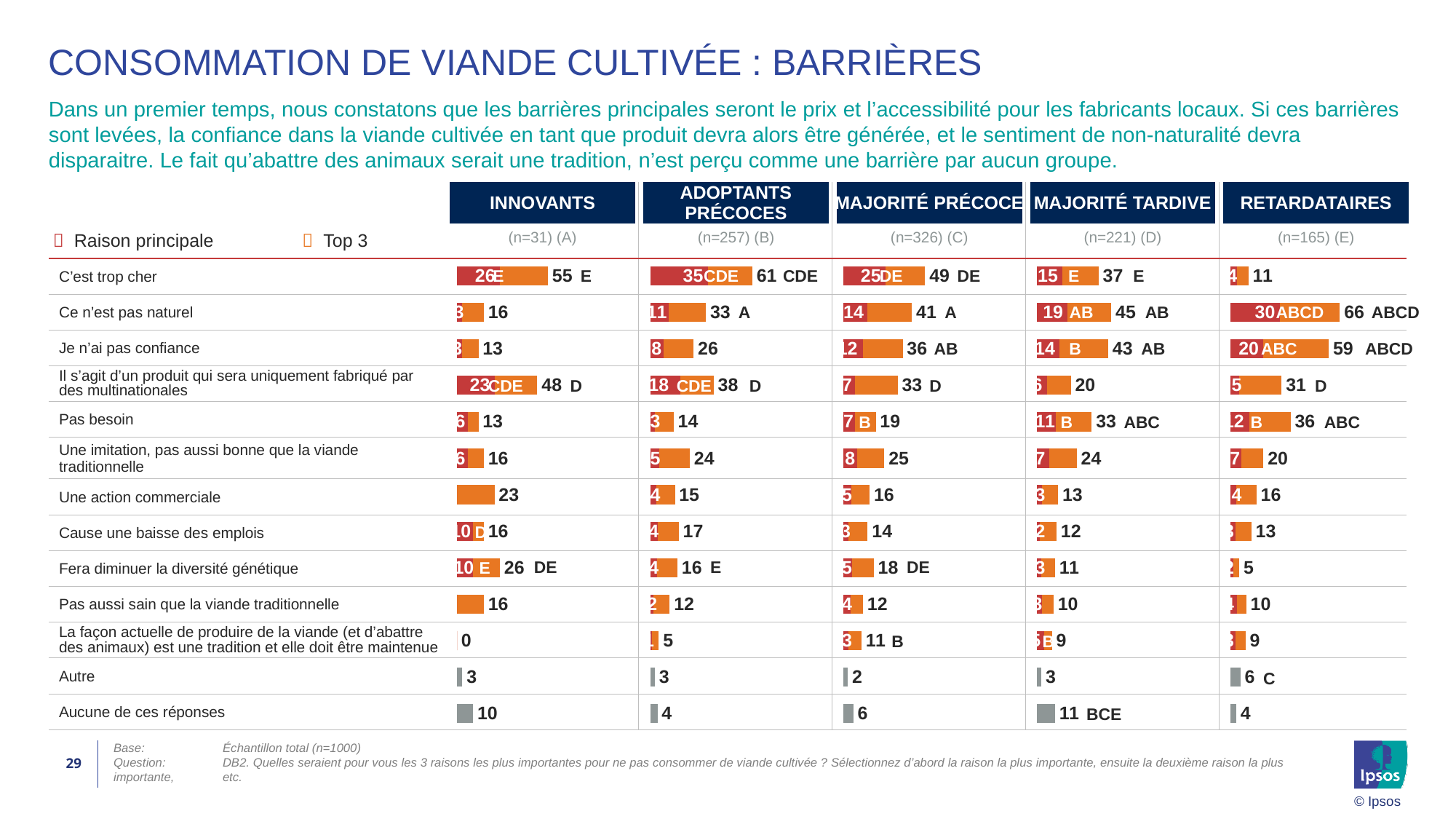
What is the Top 3 value for "C'est trop cher" among the Innovants? 55 What is the Top 3 value for "Ce n'est pas naturel" among the Retardataires? 66 How many consumer segments are shown as columns in the chart? 5 How many series does the legend list? 2 What is the Raison principale value for "C'est trop cher" among the Adoptants précoces? 35 What is the Top 3 value for "Je n'ai pas confiance" among the Retardataires? 59 What is the difference between the Top 3 values for "Ce n'est pas naturel" among the Retardataires and the Innovants? 50 What is the sample size shown for the Majorité précoce segment? n=326 Which segment has the highest Top 3 value for "C'est trop cher"? Adoptants précoces Which segment has the lowest Top 3 value for "C'est trop cher"? Retardataires What kind of chart is used to display the values in the table? Bar chart For "Pas besoin", which segment has the larger Top 3 value: Majorité tardive or Retardataires? Retardataires